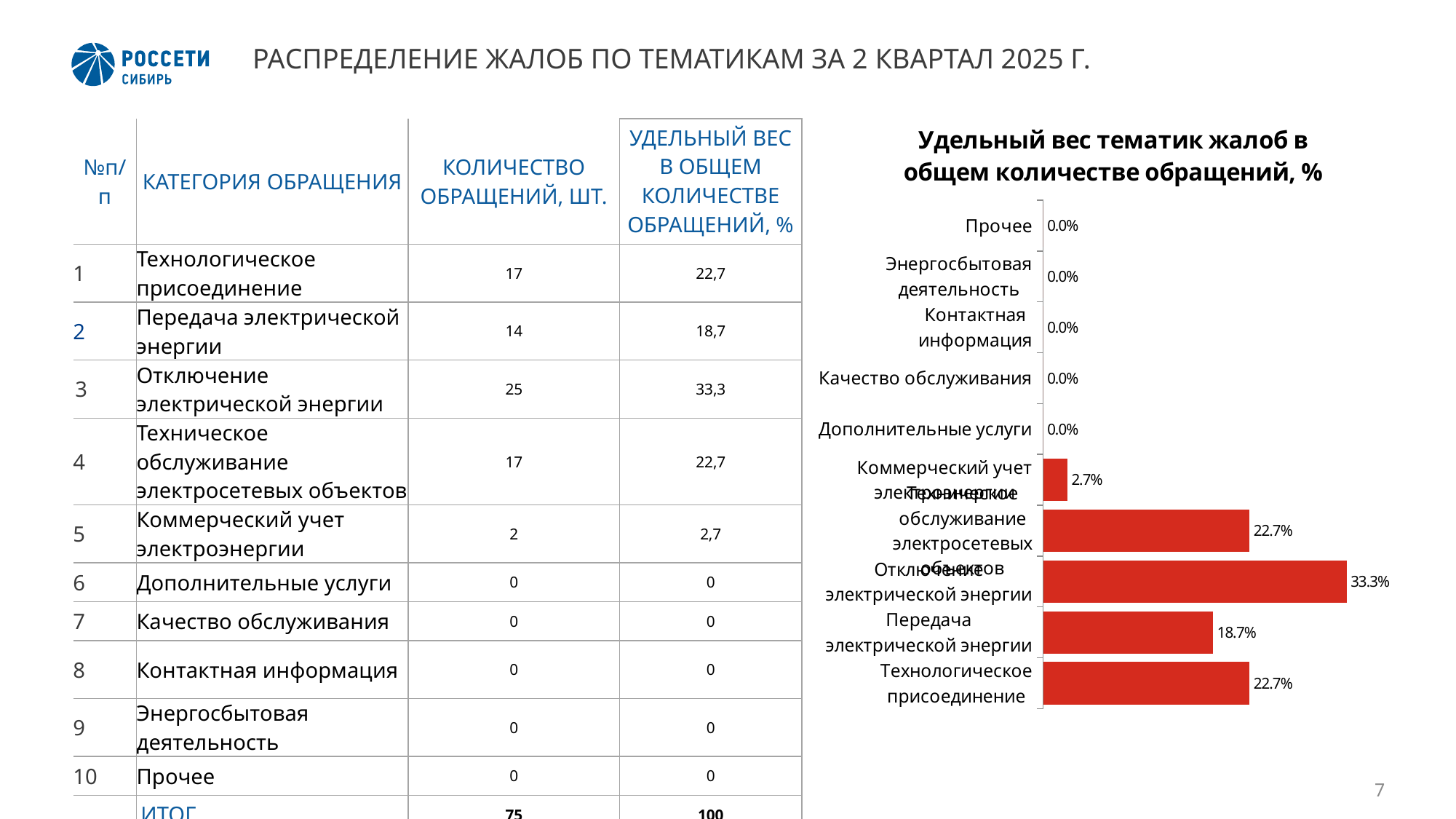
What is the value for Качество обслуживания in the chart? 0.0% Which is larger: the value for Технологическое присоединение or the value for Передача электрической энергии? Технологическое присоединение What is the value for Технологическое присоединение in the chart? 22.7% What is the title of the chart? Удельный вес тематик жалоб в общем количестве обращений, % How many categories in the chart have a value of 0.0%? 5 What type of chart is shown on the slide? bar chart Which category has the highest value in the chart? Отключение электрической энергии How many categories are shown in the chart? 10 What is the difference between the values for Отключение электрической энергии and Передача электрической энергии? 14.6% What is the value for Отключение электрической энергии in the chart? 33.3% What is the value for Коммерческий учет электроэнергии in the chart? 2.7% What is the value for Передача электрической энергии in the chart? 18.7%